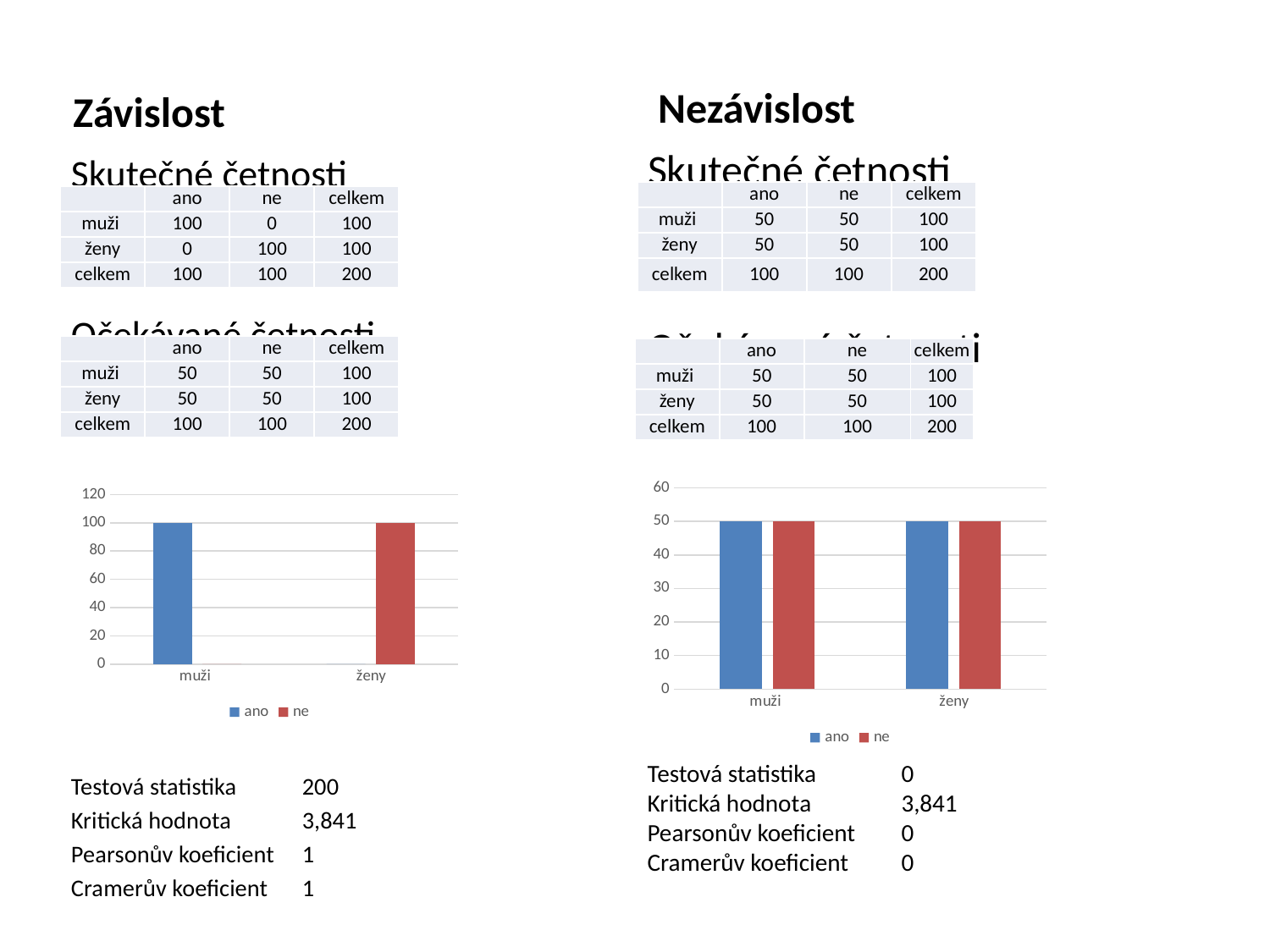
What are the two legend entries of the left chart? ano, ne In the left chart, which series has the larger value for ženy, 'ano' or 'ne'? ne What kind of chart is the left chart on the slide? bar chart In the left chart, which series has the larger value for muži, 'ano' or 'ne'? ano In the right chart, what is the value of the 'ne' bar for muži? 50 In the left chart, what is the value of the 'ano' bar for muži? 100 In the right chart, is the value of the 'ano' bar for muži greater or less than 40? greater How many series does the legend of the right chart list? 2 How many categories are shown on the x axis of the right chart? 2 In the right chart, what is the value of the 'ano' bar for ženy? 50 In the left chart, what is the value of the 'ne' bar for ženy? 100 In the left chart, what is the difference between the 'ano' value for muži and the 'ano' value for ženy? 100